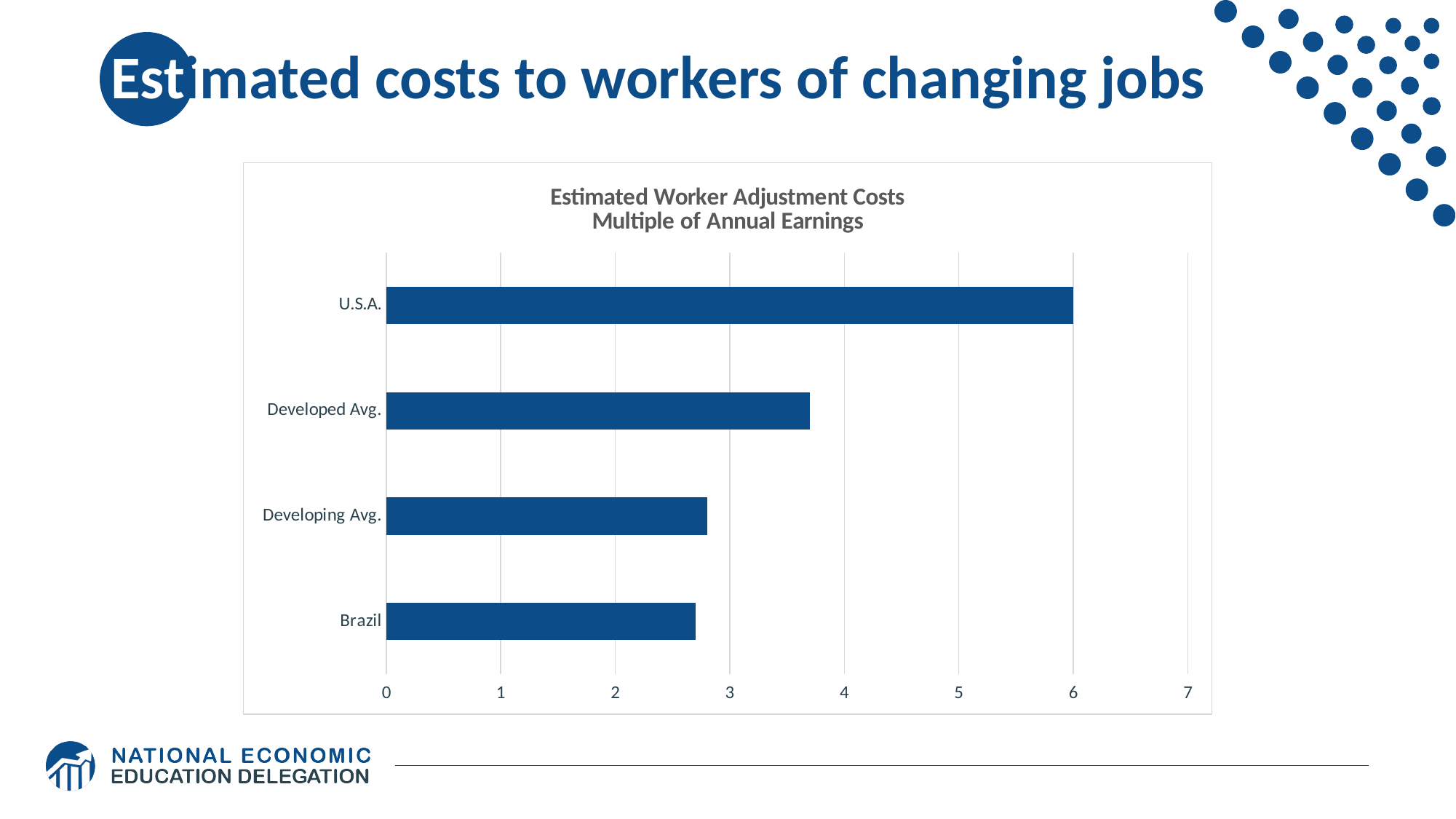
Which category has the highest estimated worker adjustment cost? U.S.A. Is the value for Developed Avg. greater or less than 4? less Which is larger, the value for Developed Avg. or the value for Brazil? Developed Avg. What is the title of the chart? Estimated Worker Adjustment Costs Multiple of Annual Earnings Is the value for Brazil greater or less than 2? greater What type of chart is shown on the slide? bar chart How many categories are plotted in the chart? 4 What is the value for U.S.A.? 6 Is the value for U.S.A. greater or less than 5? greater Which is larger, the value for U.S.A. or the value for Developed Avg.? U.S.A.